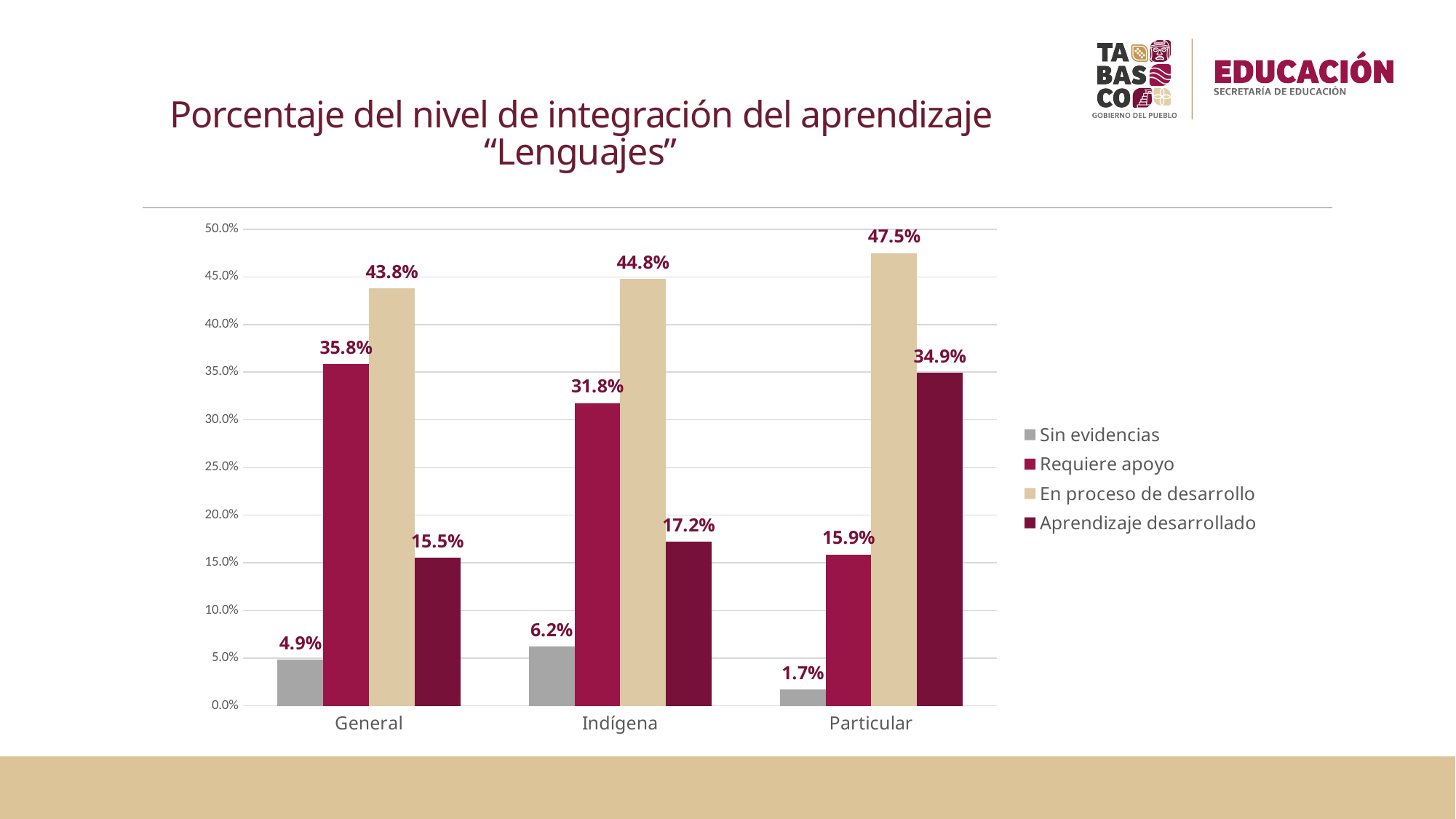
What is the value for "En proceso de desarrollo" in the Particular category? 47.5% Which is larger: "Aprendizaje desarrollado" for General or for Indígena? Indígena Is the value for "Requiere apoyo" in the Particular category greater or less than 20.0%? less What is the difference between "En proceso de desarrollo" and "Requiere apoyo" in the Indígena category? 13.0% Which category has the lowest value for "Sin evidencias"? Particular What is the value for "Sin evidencias" in the Indígena category? 6.2% What kind of chart is shown on the slide? Bar chart Which category has the highest value for "Aprendizaje desarrollado"? Particular What is the value for "Requiere apoyo" in the General category? 35.8% How many series does the legend list? 4 Which series is shown in grey in the legend? Sin evidencias How many categories are shown on the x axis? 3